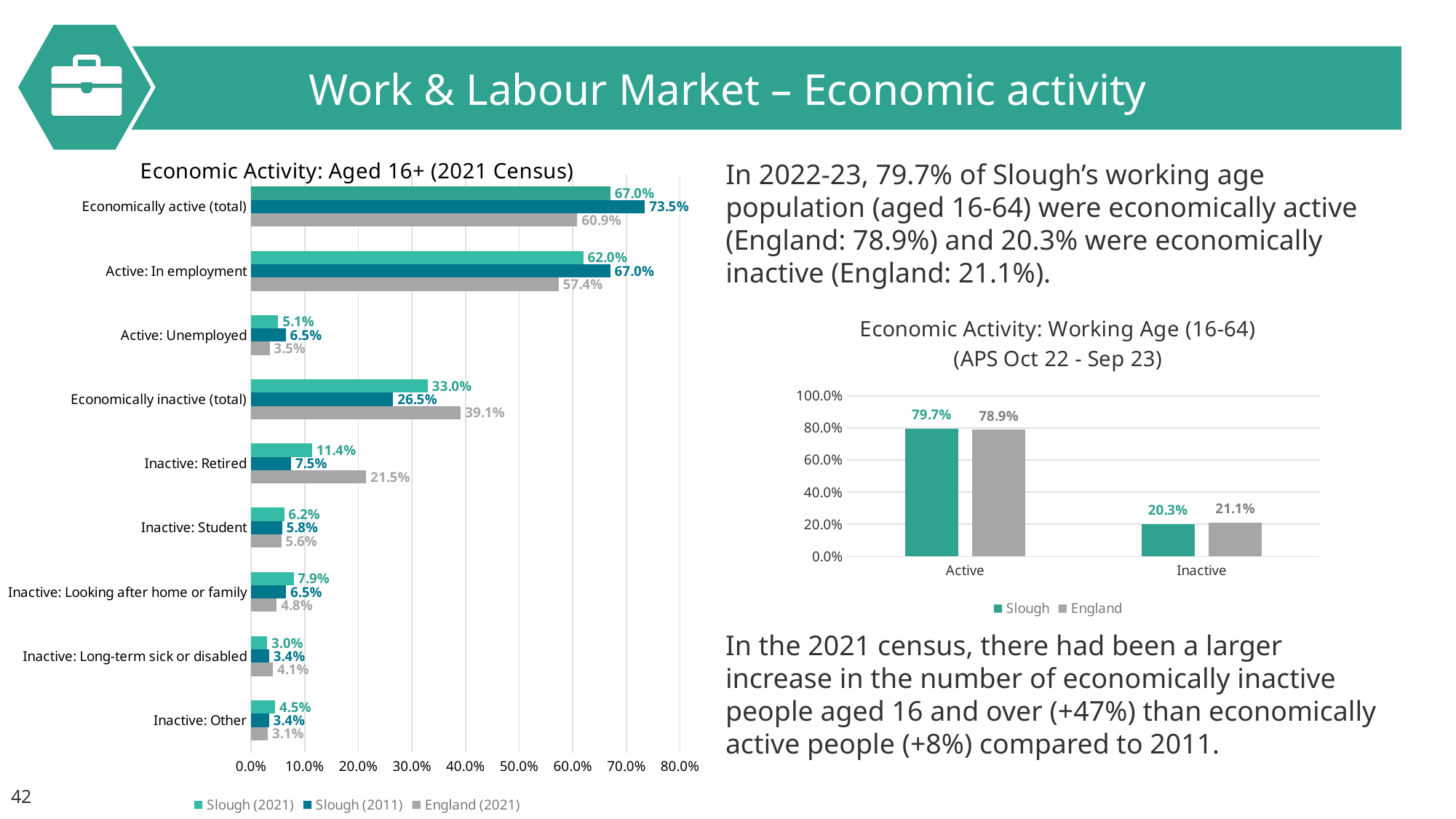
How many categories are shown in the 'Economic Activity: Aged 16+ (2021 Census)' chart? 9 In the 'Economic Activity: Aged 16+ (2021 Census)' chart, what is the England (2021) value for Inactive: Retired? 21.5% In the 'Economic Activity: Aged 16+ (2021 Census)' chart, which is larger for Economically inactive (total): Slough (2021) or England (2021)? England (2021) In the 'Economic Activity: Working Age (16-64)' chart, what is the difference between the Slough and England values for Active? 0.8% In the 'Economic Activity: Aged 16+ (2021 Census)' chart, which category has the highest Slough (2011) value? Economically active (total) What type of chart is the 'Economic Activity: Working Age (16-64)' chart? Bar chart In the 'Economic Activity: Aged 16+ (2021 Census)' chart, what is the Slough (2011) value for Active: Unemployed? 6.5% In the 'Economic Activity: Aged 16+ (2021 Census)' chart, what is the Slough (2021) value for Economically active (total)? 67.0% How many series does the legend of the 'Economic Activity: Aged 16+ (2021 Census)' chart list? 3 In the 'Economic Activity: Aged 16+ (2021 Census)' chart, what is the difference between the Slough (2011) and Slough (2021) values for Economically active (total)? 6.5% In the 'Economic Activity: Aged 16+ (2021 Census)' chart, which category has the lowest England (2021) value? Inactive: Other In the 'Economic Activity: Working Age (16-64)' chart, what is the Slough value for Inactive? 20.3%